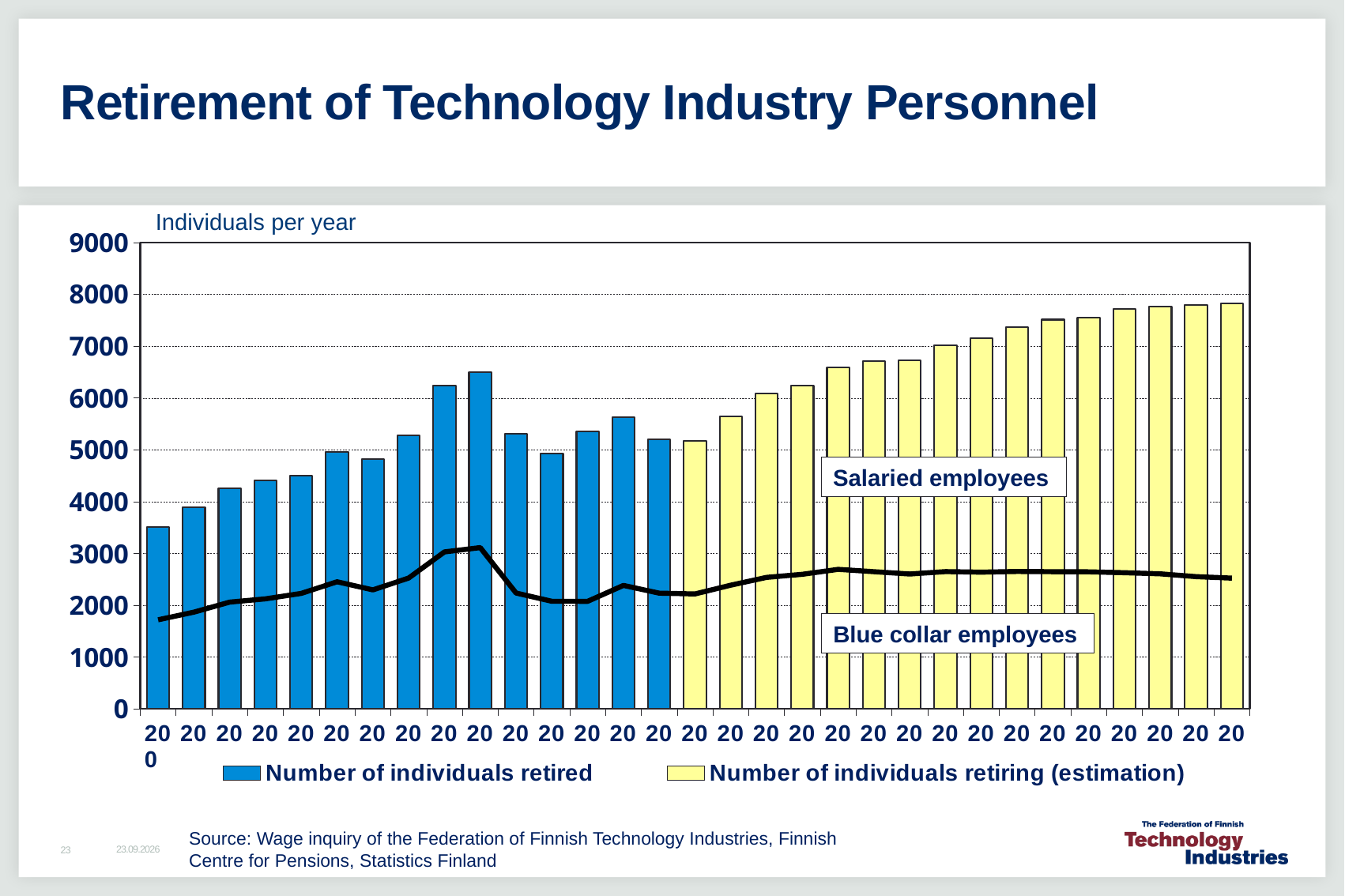
How many series does the legend list? 2 What kind of chart is shown on the slide? Combination bar and line chart Is the rightmost bar of the chart greater or less than 7000? greater Is the tallest yellow bar (Number of individuals retiring (estimation)) greater or less than 8000? less Is the leftmost bar of the chart greater or less than 4000? less Do the yellow estimation bars generally rise or fall from left to right? rise How many blue bars (Number of individuals retired) are in the chart? 15 What are the two legend entries of the chart? Number of individuals retired; Number of individuals retiring (estimation) What is the highest value shown on the y-axis? 9000 What label is shown above the y-axis of the chart? Individuals per year Which series has the tallest bar in the chart? Number of individuals retiring (estimation)